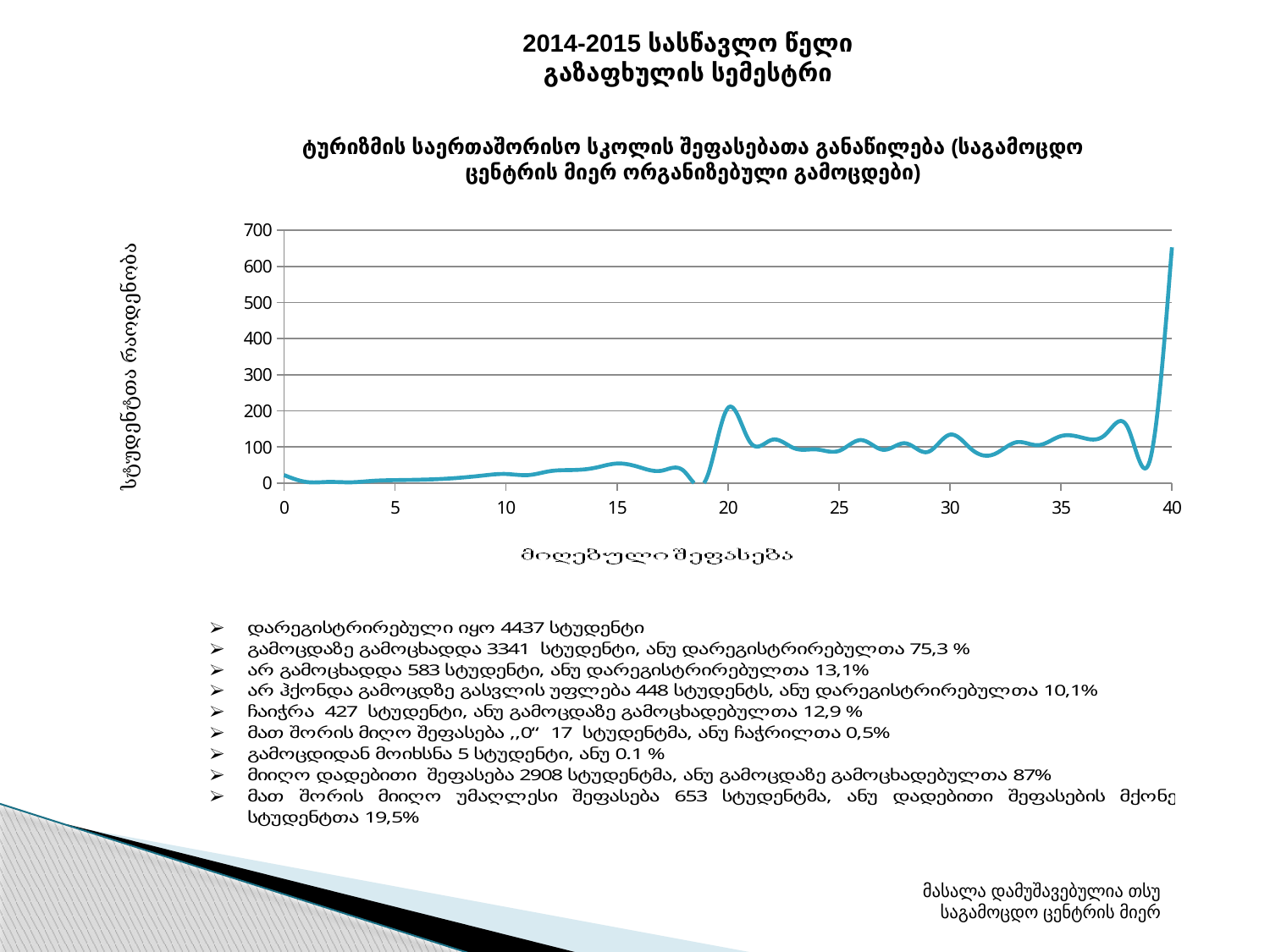
What is the highest tick value shown on the x axis? 40 Is the value at score 15 greater or less than 100? less Which has the larger value, score 20 or score 15? 20 What kind of chart is shown on the slide? line chart Does the line rise or fall between score 38 and score 40? rise Is the value at score 40 greater or less than 600? greater Is the value at score 20 greater or less than 100? greater What is the highest tick value shown on the y axis? 700 Which has the larger value, score 40 or score 20? 40 At which score on the x axis does the line reach its highest value? 40